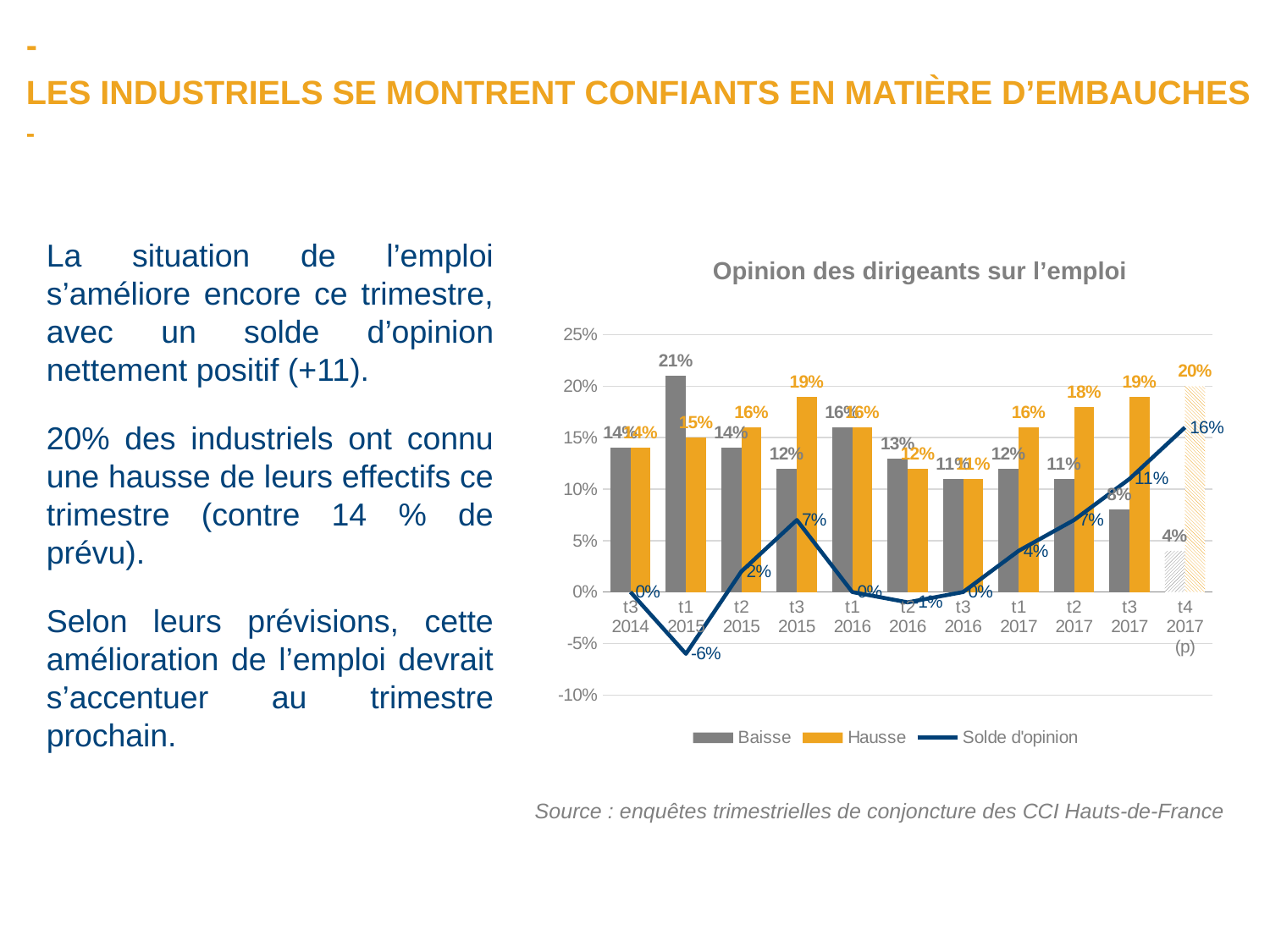
What is the value of the Baisse series for t1 2015? 21% In which quarter is the Solde d'opinion lowest? t1 2015 What is the difference between the Hausse and Baisse values for t3 2017? 11% Does the Solde d'opinion line rise or fall from t3 2016 to t4 2017 (p)? Rise For t3 2015, which is larger, Baisse or Hausse? Hausse What is the Solde d'opinion value for t1 2015? -6% In which quarter is the Baisse series highest? t1 2015 How many quarters are shown on the x axis? 11 What kind of chart is shown? Combined bar and line chart What is the value of the Hausse series for t3 2017? 19% How many series does the legend list? 3 What is the Hausse value for t4 2017 (p)? 20%